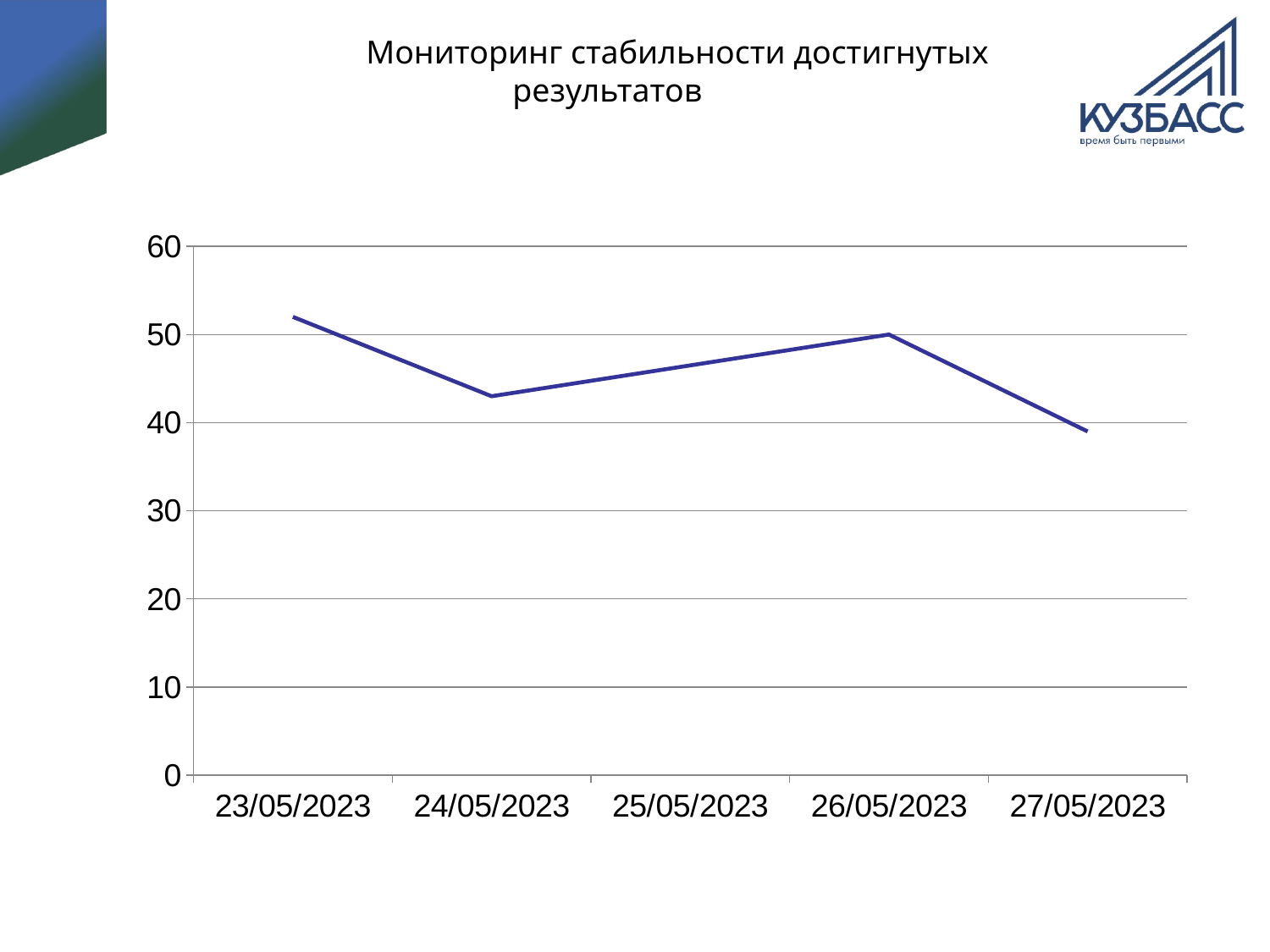
Which is larger, the value for 24/05/2023 or the value for 26/05/2023? 26/05/2023 How many dates are plotted along the x axis? 5 What is the value for 26/05/2023? 50 Does the line rise or fall from 26/05/2023 to 27/05/2023? fall What is the title of the chart? Мониторинг стабильности достигнутых результатов Which date has the highest value? 23/05/2023 What kind of chart is shown on the slide? line chart Is the value for 23/05/2023 greater or less than 50? greater Which date has the lowest value? 27/05/2023 Is the value for 24/05/2023 greater or less than 50? less